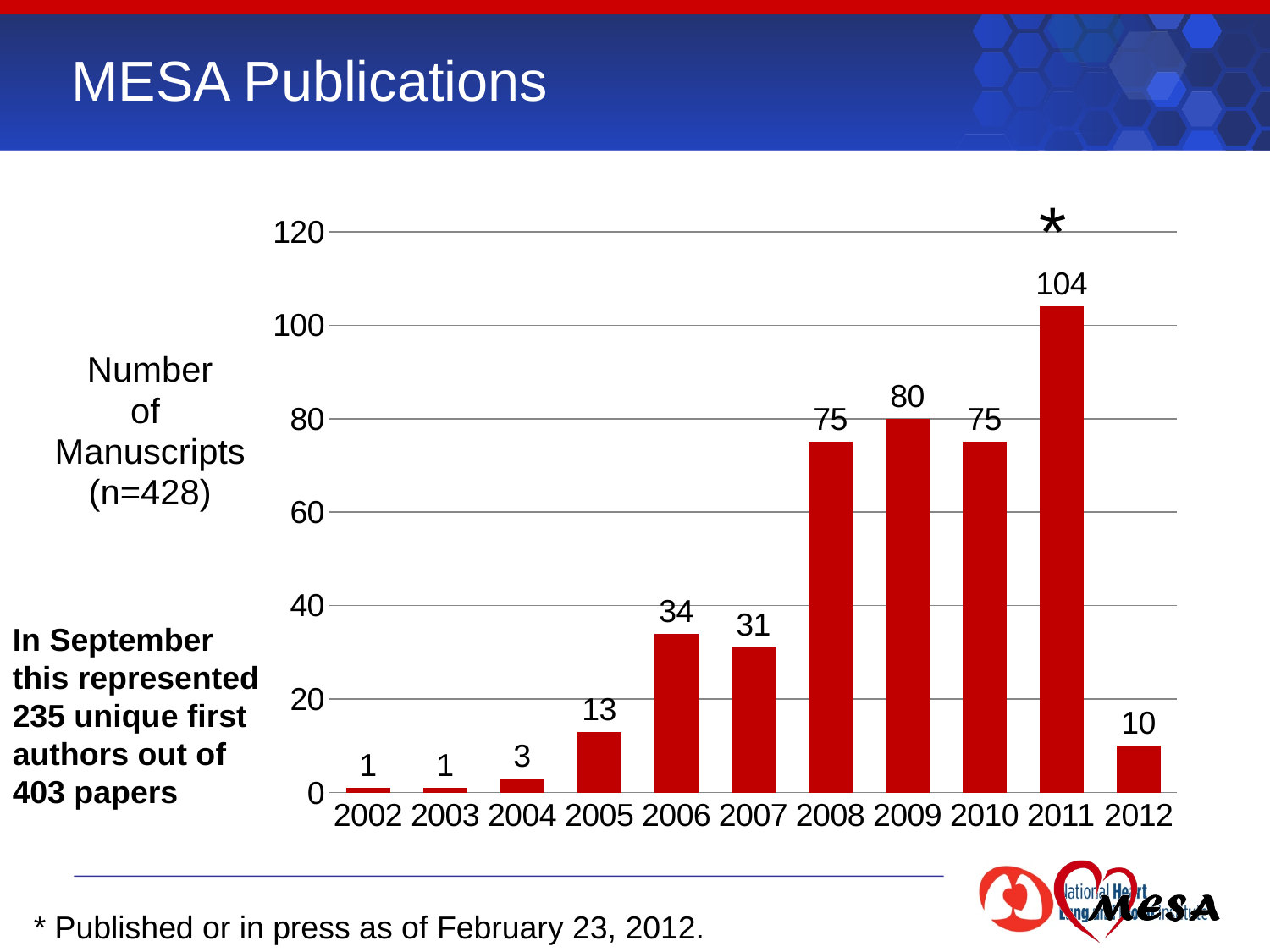
How many manuscripts were published in 2011? 104 What is the total number of manuscripts shown in the chart's y-axis label (n=)? 428 What is the difference in number of manuscripts between 2011 and 2010? 29 What is the number of manuscripts for 2012? 10 What is the number of manuscripts for 2006? 34 What kind of chart is shown on the slide? bar chart How many years are shown on the x axis of the chart? 11 Which year has more manuscripts, 2009 or 2007? 2009 What is the difference in number of manuscripts between 2006 and 2007? 3 Which year has the highest number of manuscripts? 2011 What is the number of manuscripts for 2005? 13 Which year is marked with an asterisk on the chart? 2011